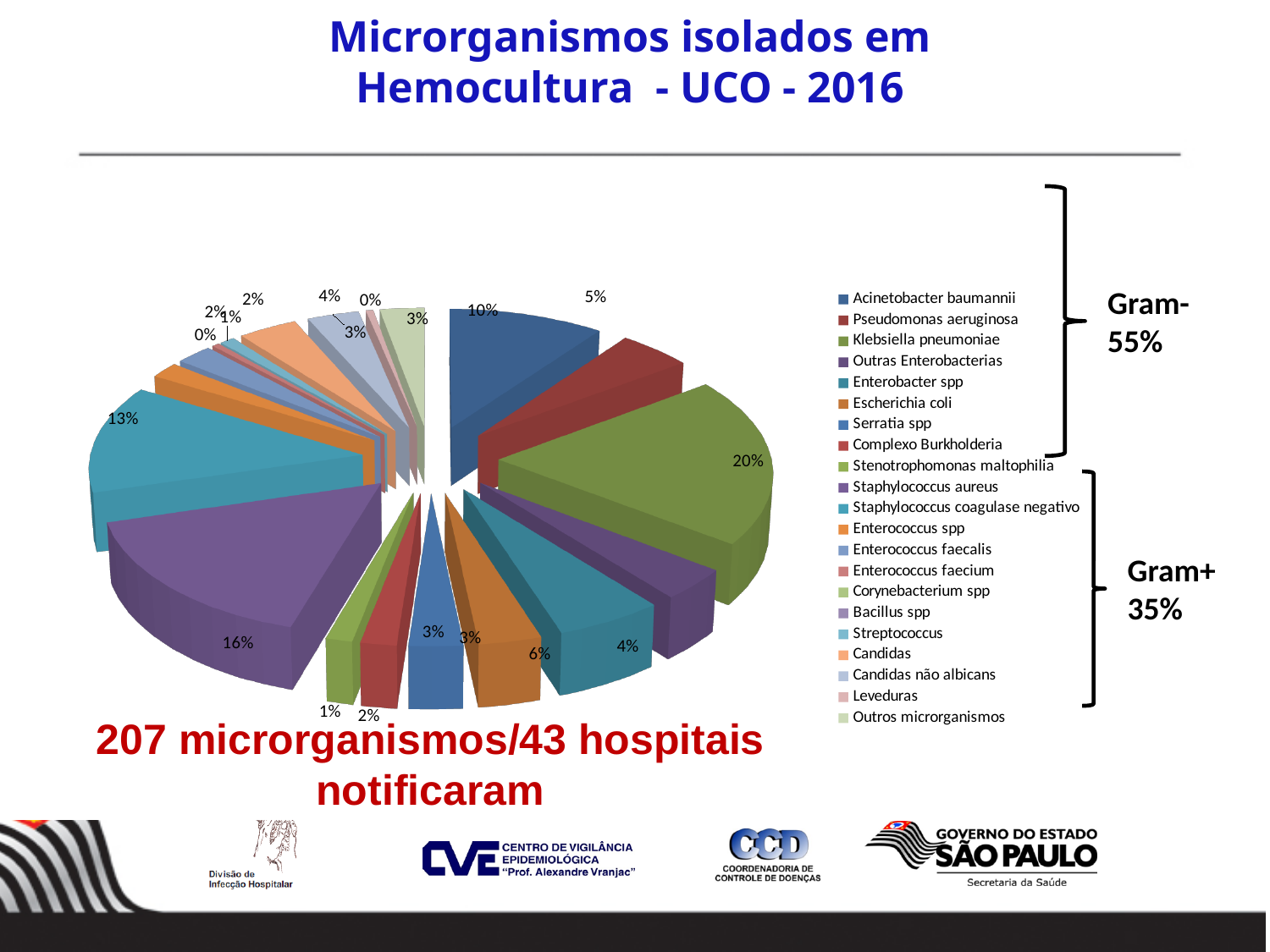
Which is larger, the slice for Staphylococcus aureus or the slice for Staphylococcus coagulase negativo? Staphylococcus aureus What share of the isolates is labelled as Gram+ on the slide? 35% What is the difference in percentage points between Klebsiella pneumoniae (20%) and Staphylococcus aureus (16%)? 4 percentage points What kind of chart is shown on the slide? Pie chart What percentage is shown for Staphylococcus aureus? 16% What percentage is shown for Acinetobacter baumannii? 10% What share of the isolates is labelled as Gram- on the slide? 55% According to the text below the chart, how many microorganisms were isolated and how many hospitals notified? 207 microrganismos / 43 hospitais Which microorganism has the largest slice of the pie? Klebsiella pneumoniae How many microorganism categories does the legend list? 21 What percentage of the pie does Klebsiella pneumoniae represent? 20% What percentage is shown for Staphylococcus coagulase negativo? 13%